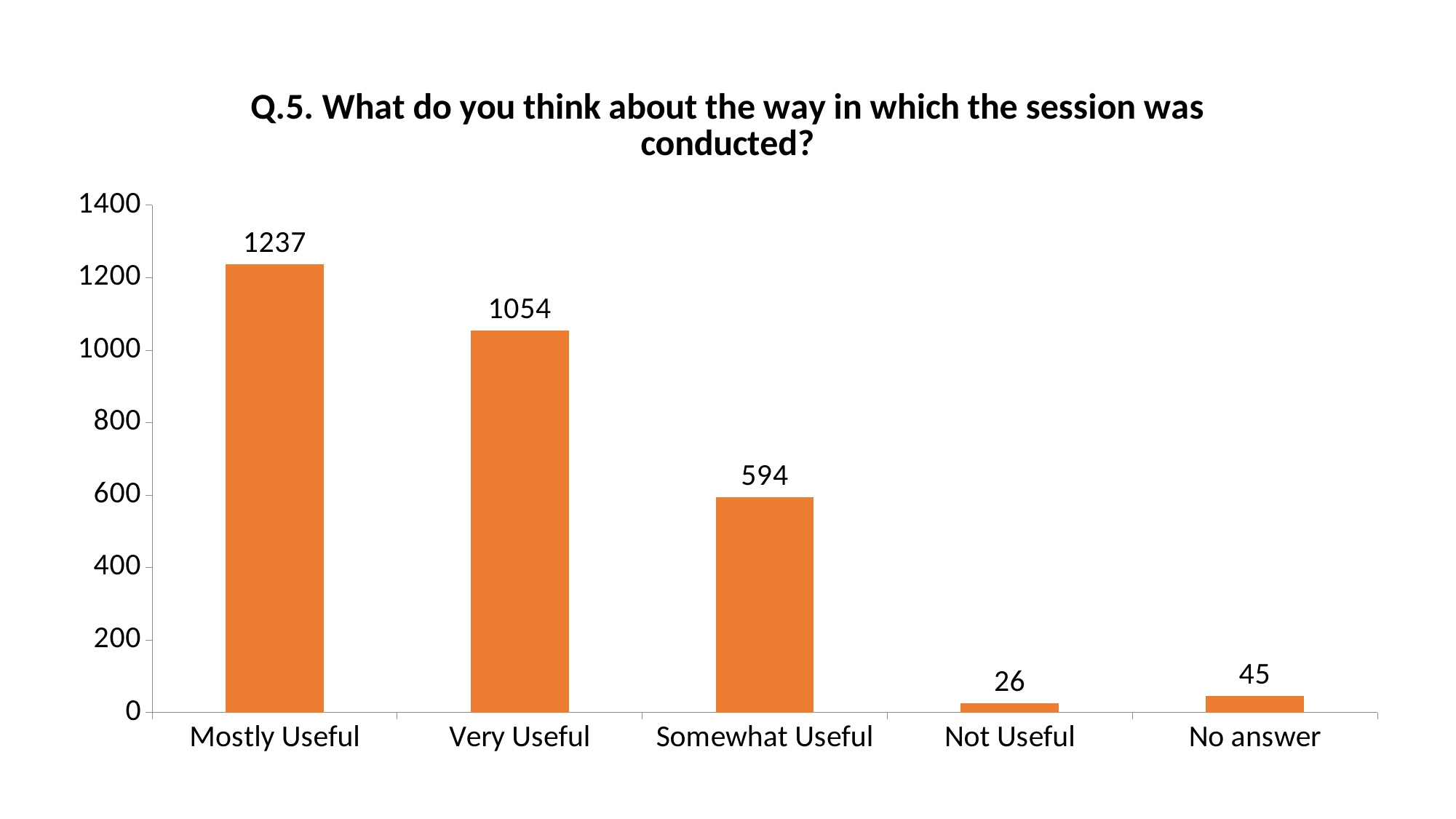
Which category has the lowest value? Not Useful What kind of chart is shown on the slide? Bar chart What is the value for Very Useful? 1054 What is the value for Not Useful? 26 How many categories are shown on the x axis? 5 Which is larger, the value for No answer or the value for Not Useful? No answer What is the value for No answer? 45 What is the difference between the values for Mostly Useful and Very Useful? 183 Which category has the highest value? Mostly Useful What is the title of the chart? Q.5. What do you think about the way in which the session was conducted? What is the value for Mostly Useful? 1237 What is the value for Somewhat Useful? 594